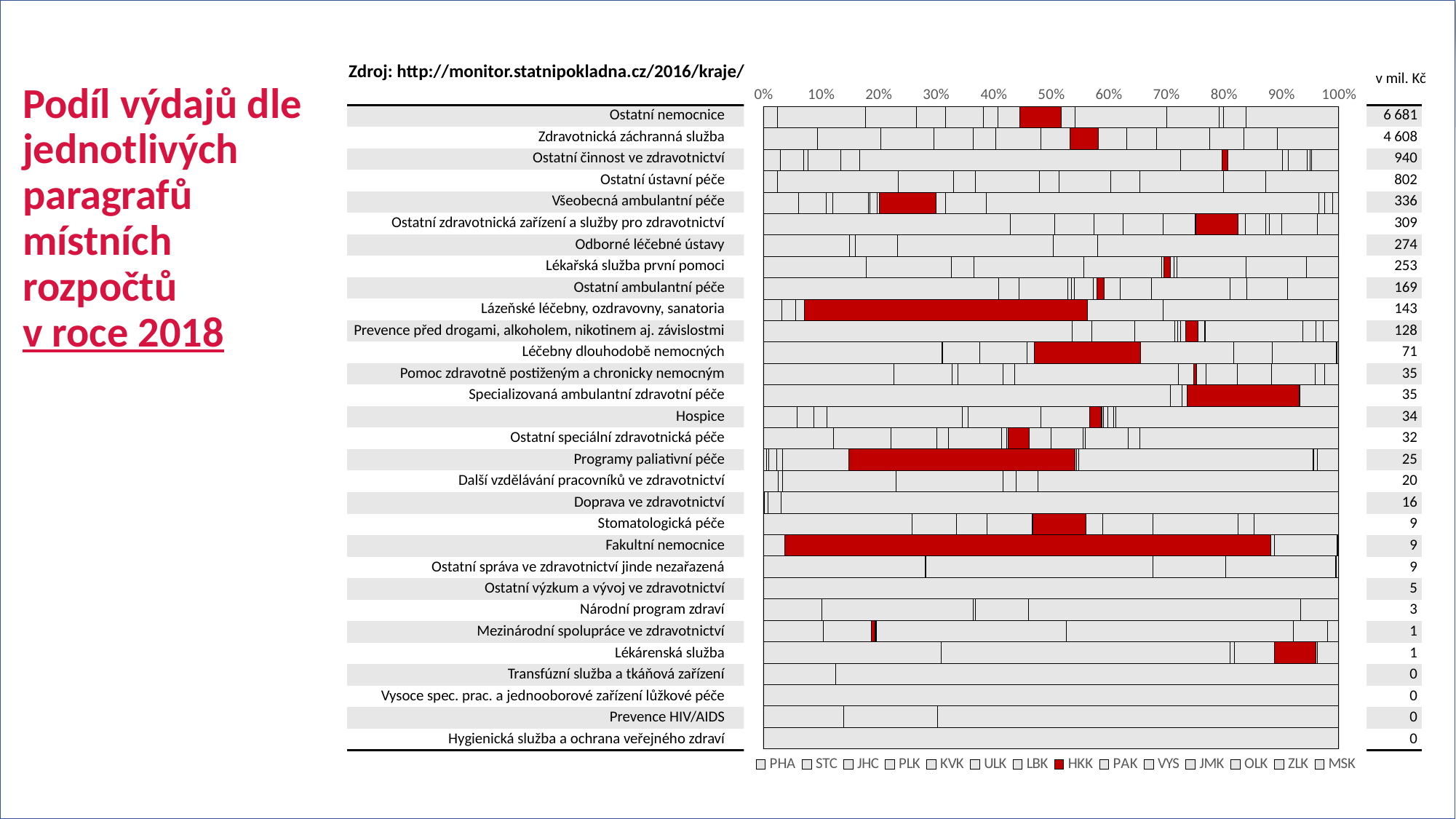
What is the value in mil. Kč shown for Ostatní nemocnice? 6 681 How many categories (rows) are shown in the chart? 30 Is the HKK share of Lázeňské léčebny, ozdravovny, sanatoria greater or less than 40%? greater What kind of chart is shown on the slide? Stacked bar chart Which category has the highest value in mil. Kč? Ostatní nemocnice Which series is highlighted in red in the chart? HKK How many series does the legend list? 14 What is the value in mil. Kč shown for Zdravotnická záchranná služba? 4 608 Which has a larger value in mil. Kč, Ostatní činnost ve zdravotnictví or Ostatní ústavní péče? Ostatní činnost ve zdravotnictví Is the HKK share of Fakultní nemocnice greater or less than 80%? greater What is the difference in mil. Kč between Ostatní nemocnice and Zdravotnická záchranná služba? 2 073 What is the value in mil. Kč shown for Lázeňské léčebny, ozdravovny, sanatoria? 143